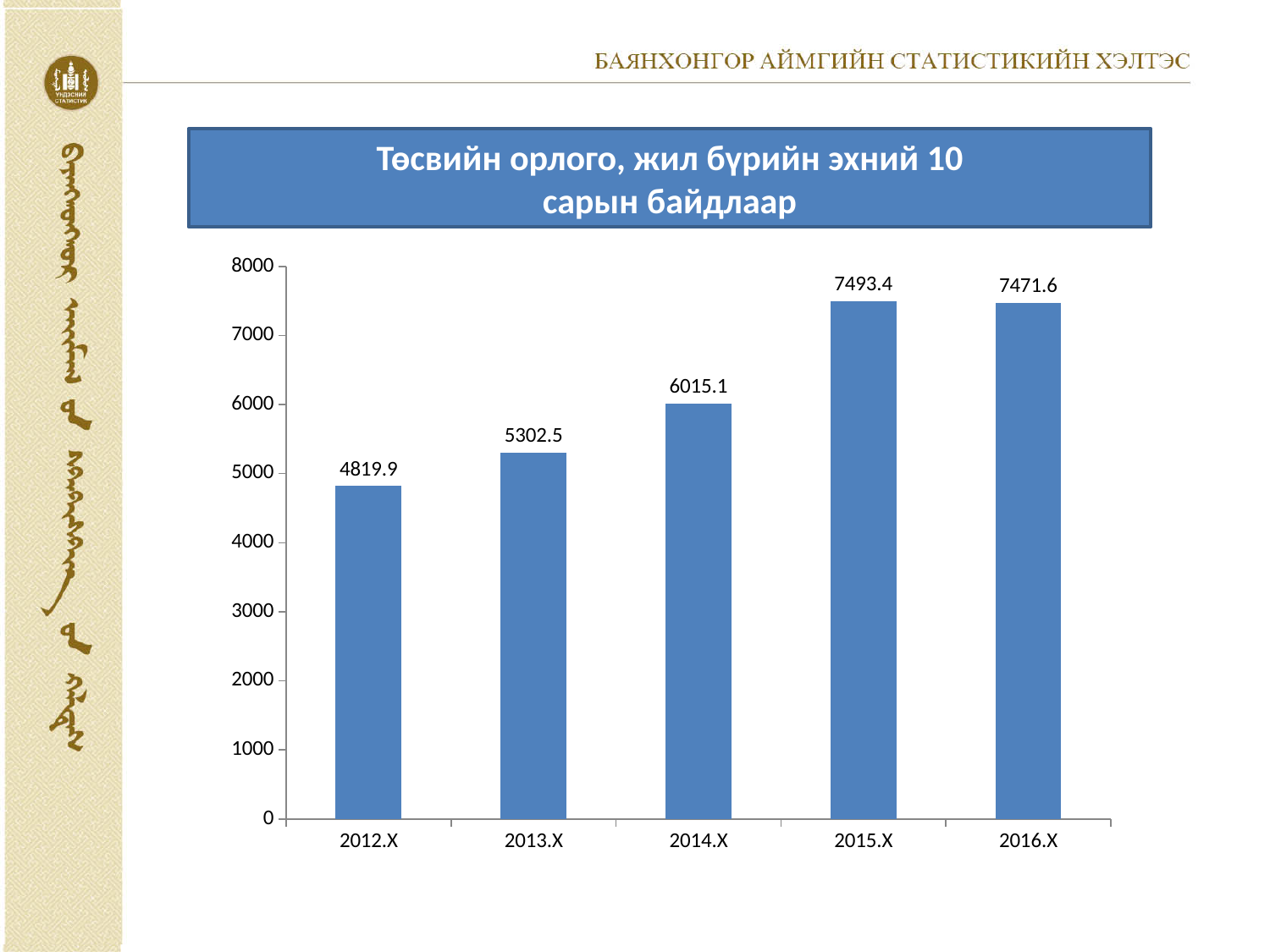
What is the value for 2014.X? 6015.1 Is the value for 2014.X greater or less than 5000? greater What kind of chart is shown on the slide? bar chart How many categories are shown on the x axis? 5 What is the difference between the values for 2015.X and 2016.X? 21.8 What is the value for 2012.X? 4819.9 Which category has the highest value? 2015.X What is the value for 2016.X? 7471.6 Which category has the lowest value? 2012.X What is the difference between the values for 2013.X and 2012.X? 482.6 Do the values rise or fall from 2012.X to 2015.X? rise Which is larger, the value for 2014.X or the value for 2013.X? 2014.X